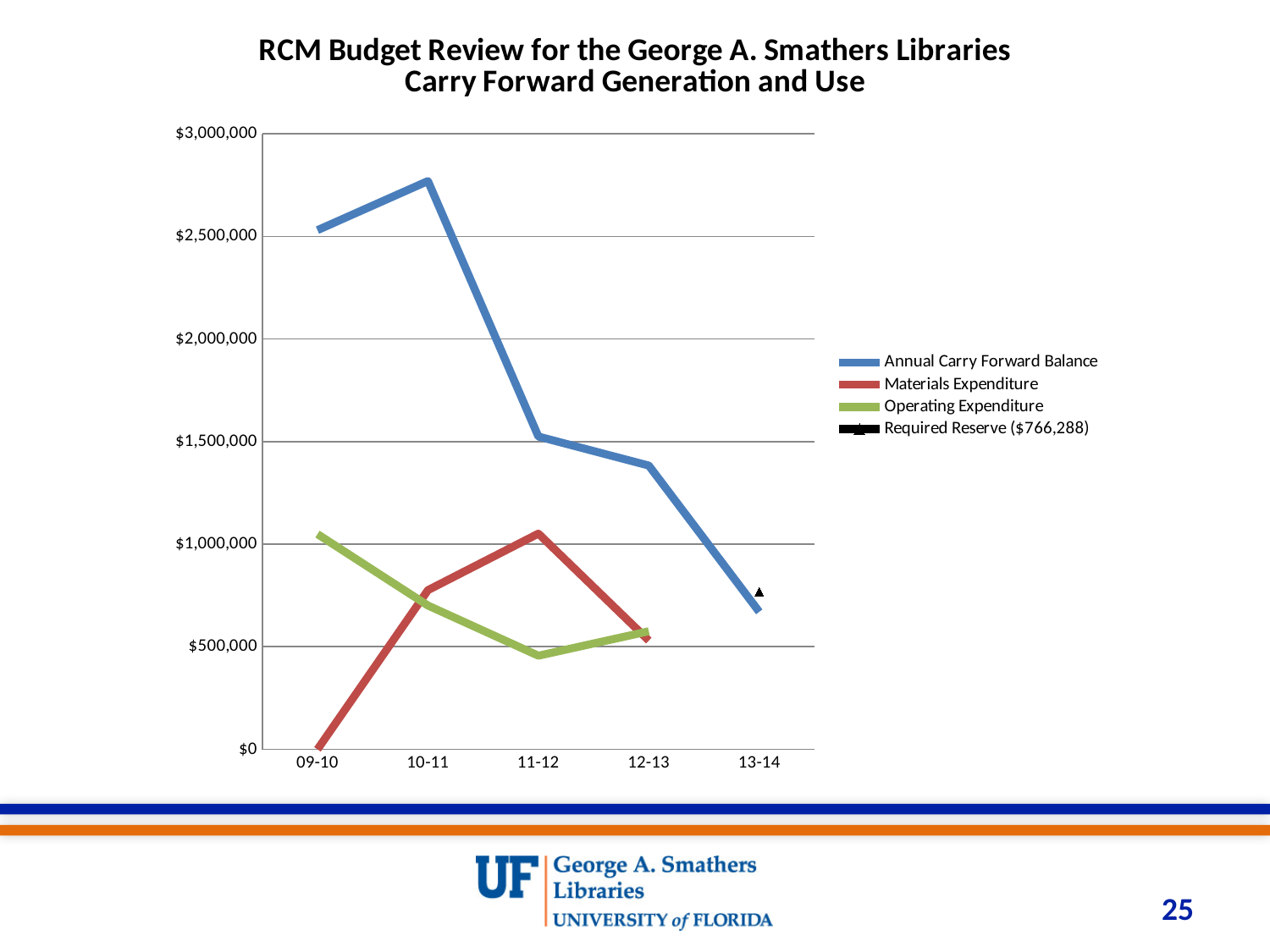
In which year is the Annual Carry Forward Balance lowest? 13-14 How many series does the legend list? 4 What is the value of the Required Reserve shown in the legend? $766,288 In which year is Materials Expenditure highest? 11-12 Is the Annual Carry Forward Balance for 10-11 greater or less than $2,500,000? greater What is the title of the chart? RCM Budget Review for the George A. Smathers Libraries Carry Forward Generation and Use Is the Annual Carry Forward Balance for 12-13 greater or less than $1,500,000? less Does the Annual Carry Forward Balance rise or fall from 10-11 to 13-14? fall What kind of chart is shown on the slide? line chart In which year is the Annual Carry Forward Balance highest? 10-11 How many fiscal years are shown on the x axis? 5 In 09-10, which is larger: Operating Expenditure or Materials Expenditure? Operating Expenditure